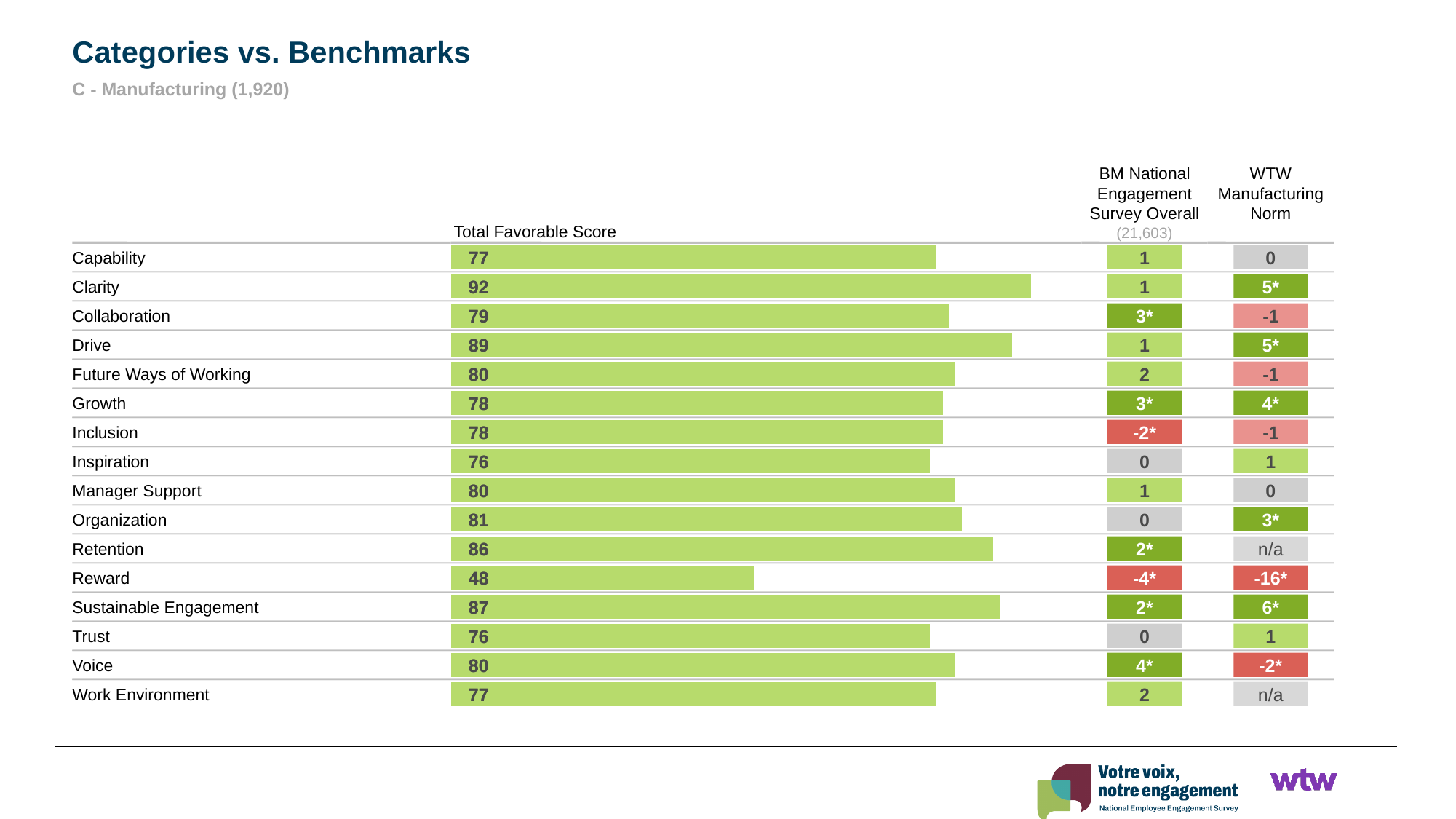
What is the title of the slide? Categories vs. Benchmarks What is the Total Favorable Score for Clarity? 92 Which has a higher Total Favorable Score, Drive or Retention? Drive What is the value shown for Reward in the WTW Manufacturing Norm column? -16* Which category has the highest Total Favorable Score? Clarity What is the value shown for Voice in the BM National Engagement Survey Overall column? 4* What is the difference between the Total Favorable Scores for Clarity and Reward? 44 Which category has the lowest Total Favorable Score? Reward What is the Total Favorable Score for Reward? 48 What is the difference between the Total Favorable Scores for Sustainable Engagement and Trust? 11 How many categories are shown in the chart? 16 What kind of chart is used to show the Total Favorable Scores? Bar chart